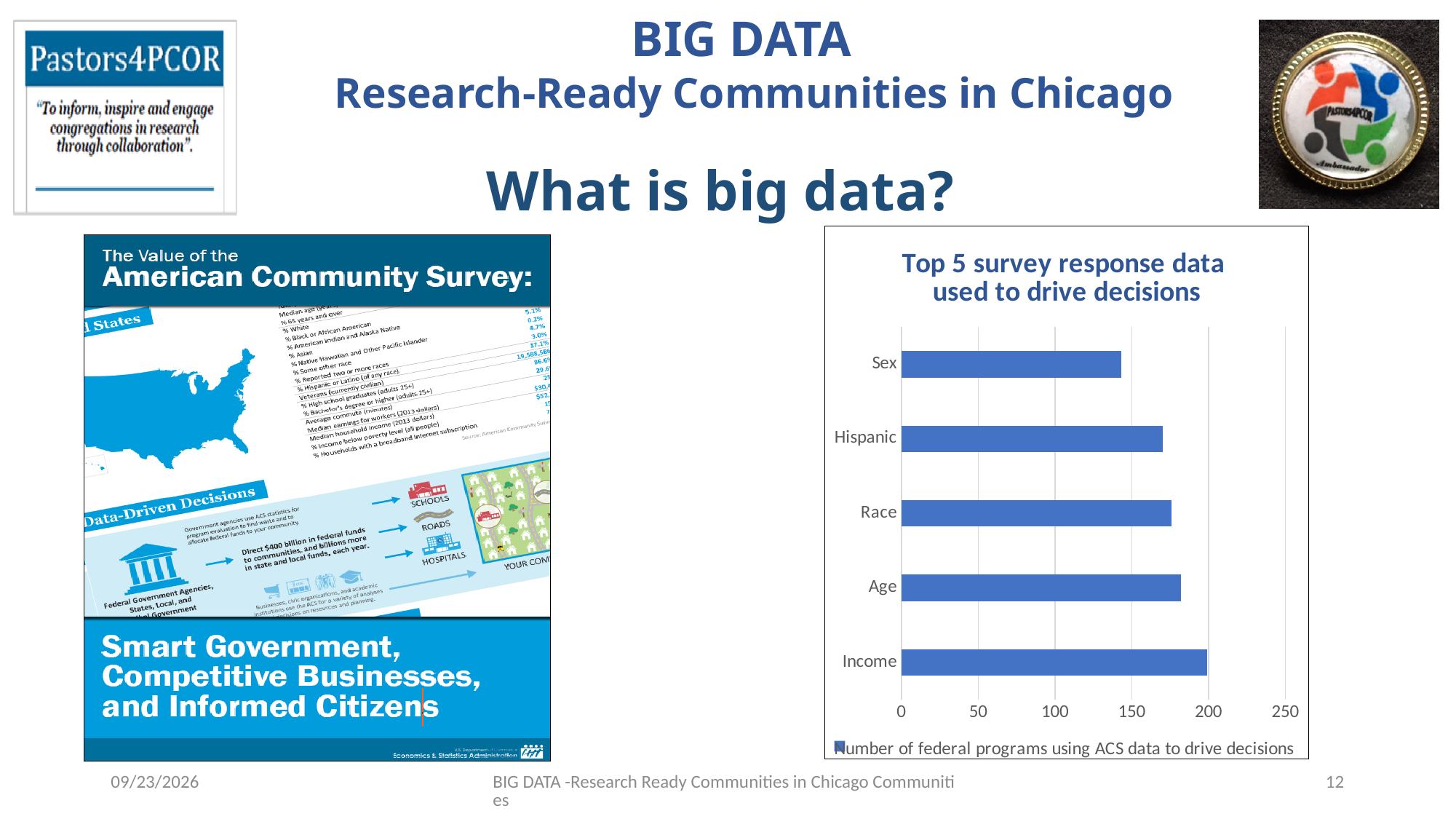
How many series does the chart's legend list? 1 What series name does the chart's legend show? Number of federal programs using ACS data to drive decisions What is the title of the chart? Top 5 survey response data used to drive decisions Which is larger, the value for Income or the value for Sex? Income Which category has the highest value in the chart? Income Is the value for Sex greater or less than 150? less What kind of chart is shown on the slide? bar chart How many categories are plotted in the chart? 5 Which category has the lowest value in the chart? Sex Is the value for Age greater or less than 150? greater Is the value for Income greater or less than 150? greater